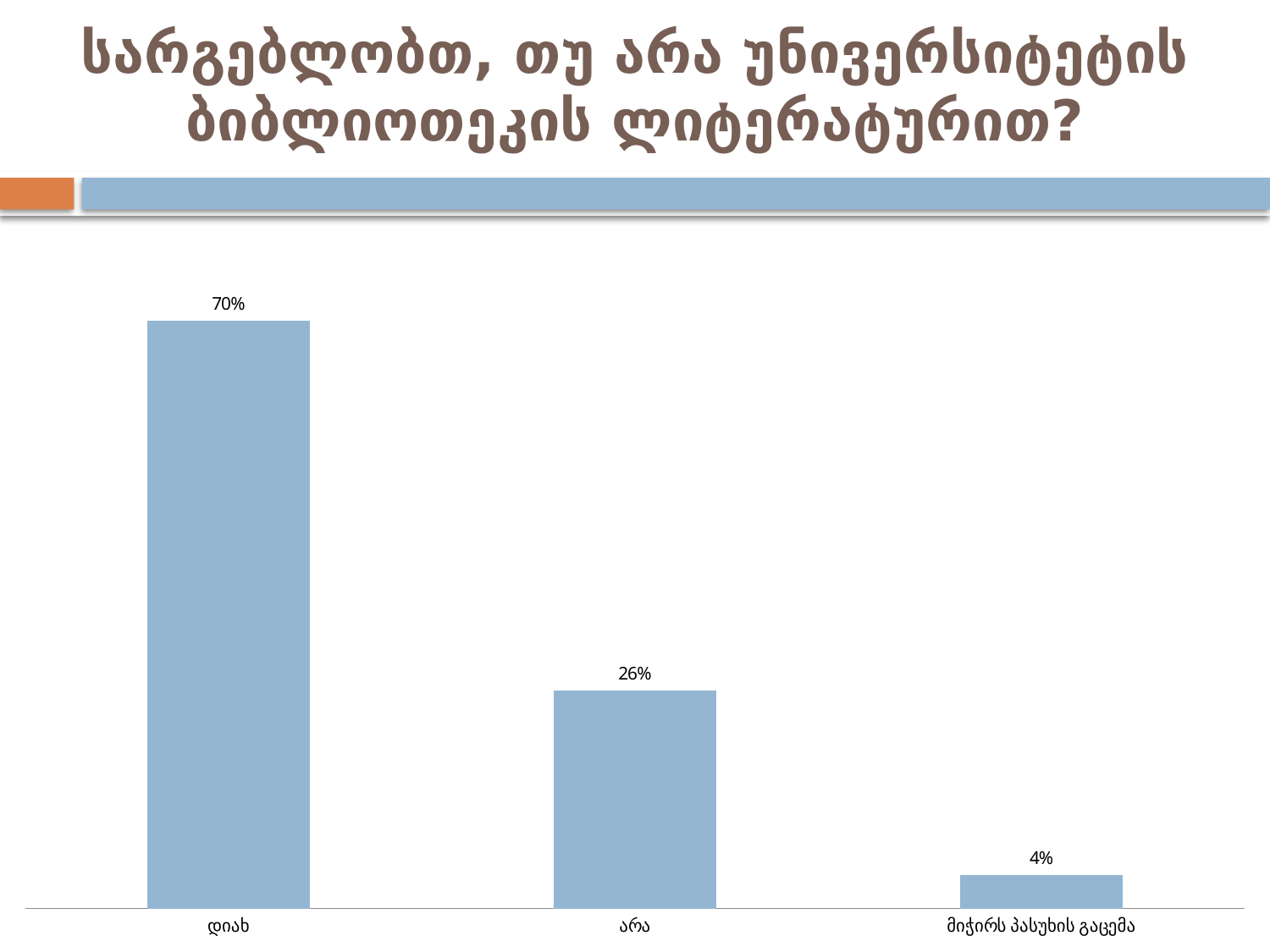
Do the values rise or fall from left to right across the categories? fall Which is larger, the value for არა or the value for მიჭირს პასუხის გაცემა? არა What is the difference between the values for დიახ and არა? 44% What kind of chart is shown on the slide? bar chart What is the value for მიჭირს პასუხის გაცემა? 4% How many categories are shown in the chart? 3 What is the value for არა? 26% Which category has the highest value? დიახ Which category has the lowest value? მიჭირს პასუხის გაცემა What is the difference between the values for არა and მიჭირს პასუხის გაცემა? 22% What is the value for დიახ? 70% What is the title of the slide? სარგებლობთ, თუ არა უნივერსიტეტის ბიბლიოთეკის ლიტერატურით?